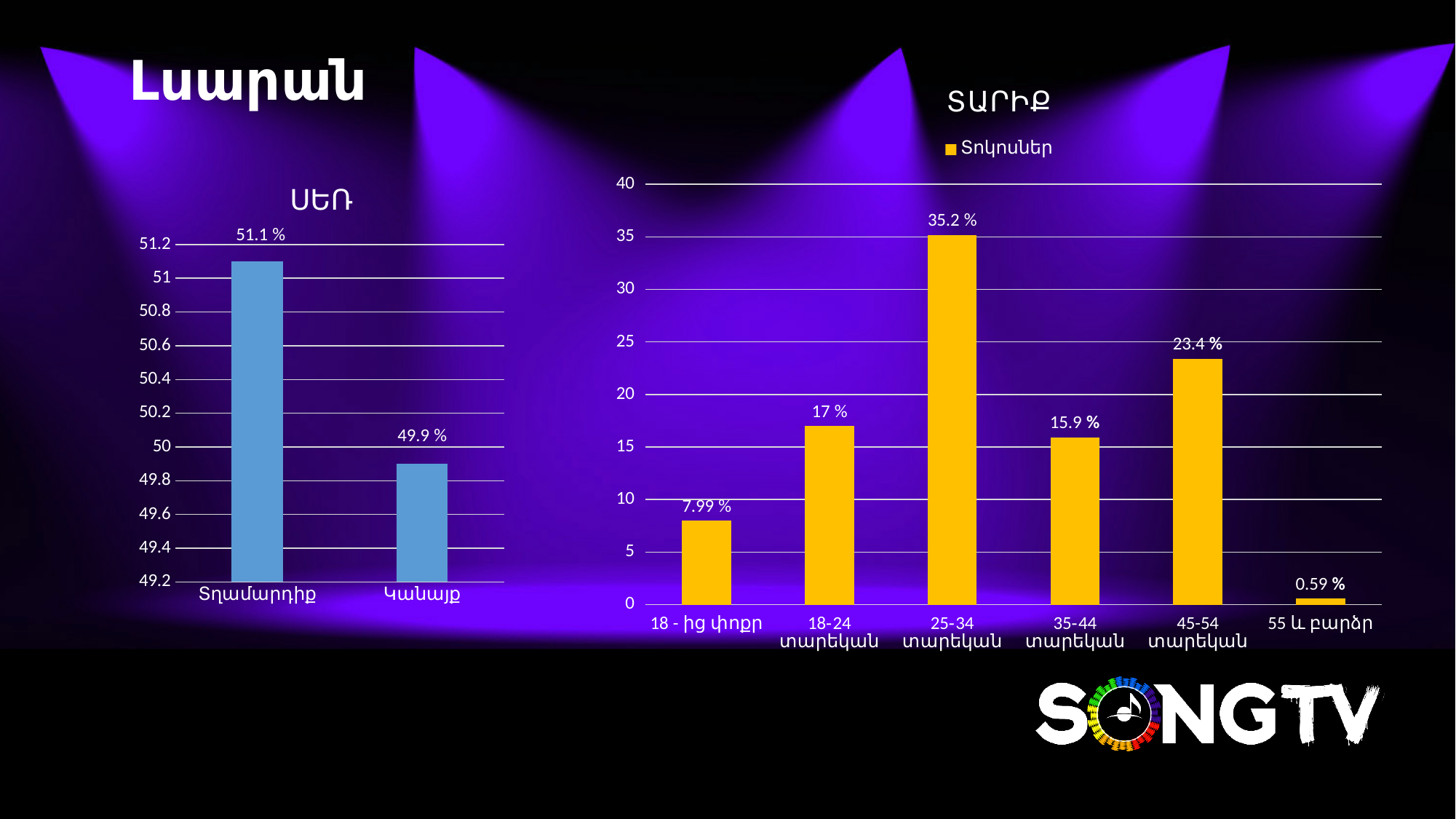
In the ՏԱՐԻՔ chart, which category has the highest value? 25-34 տարեկան In the ՏԱՐԻՔ chart, which is larger: the value for 18-24 տարեկան or 45-54 տարեկան? 45-54 տարեկան In the ՏԱՐԻՔ chart, what series name does the legend show? Տոկոսներ In the ՍԵՌ chart, what is the value for Կանայք? 49.9 % In the ՍԵՌ chart, what is the difference between the values for Տղամարդիկ and Կանայք? 1.2 % In the ՍԵՌ chart, what is the value for Տղամարդիկ? 51.1 % In the ՏԱՐԻՔ chart, how many categories are shown on the x axis? 6 In the ՏԱՐԻՔ chart, what is the difference between the values for 45-54 տարեկան and 35-44 տարեկան? 7.5 % In the ՏԱՐԻՔ chart, what is the value for 18 - ից փոքր? 7.99 % In the ՏԱՐԻՔ chart, what is the value for 25-34 տարեկան? 35.2 % In the ՍԵՌ chart, how many categories are shown? 2 In the ՏԱՐԻՔ chart, which category has the lowest value? 55 և բարձր